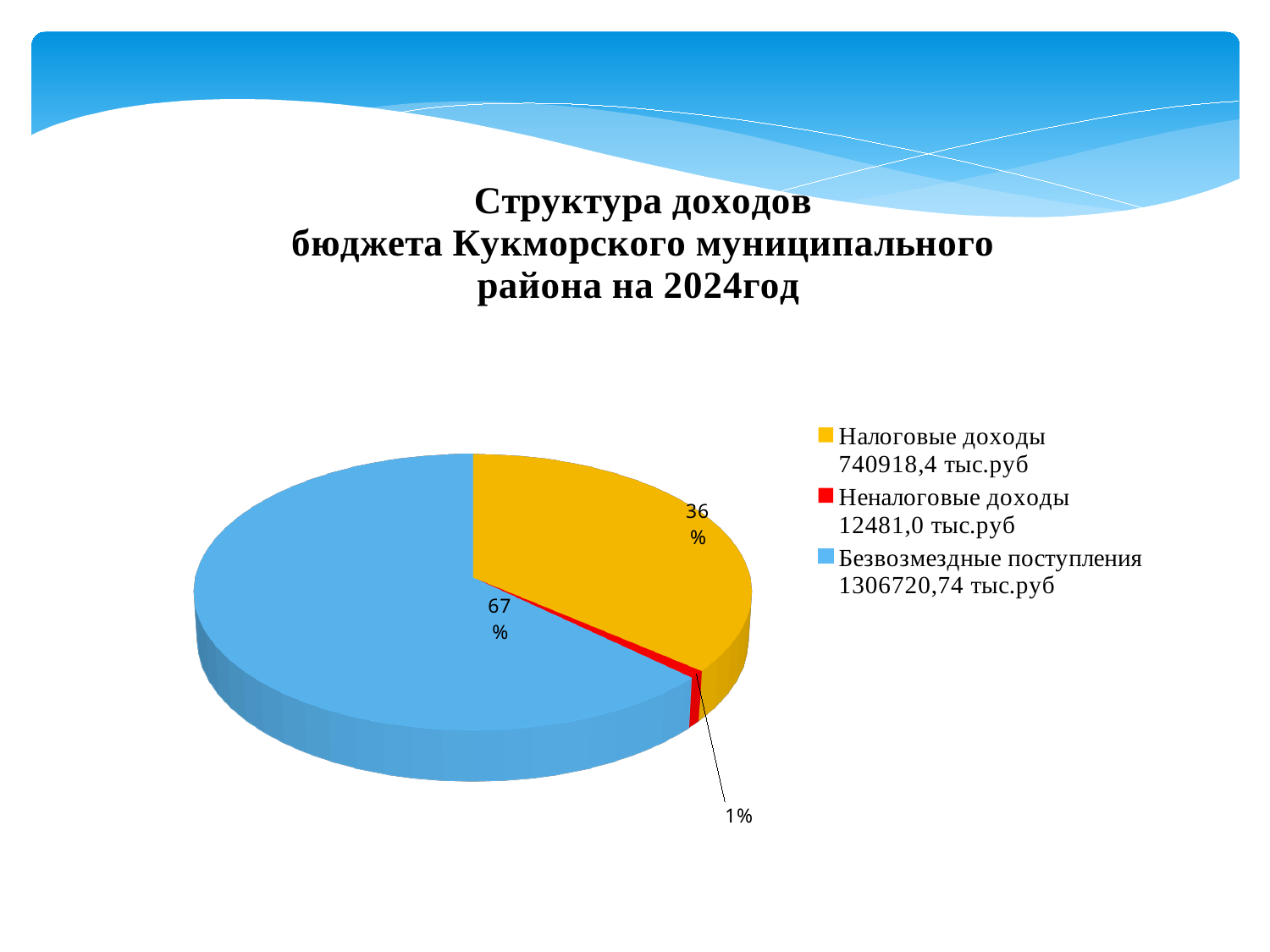
What share of the pie is Безвозмездные поступления? 67% What amount in тыс.руб does the legend give for Налоговые доходы? 740918,4 тыс.руб Which category has the smallest share of the pie? Неналоговые доходы How many entries does the legend list? 3 Which is larger: the share for Налоговые доходы or the share for Безвозмездные поступления? Безвозмездные поступления How many slices does the pie chart have? 3 What is the difference in percentage points between the shares of Безвозмездные поступления and Налоговые доходы? 31 What share of the pie is Налоговые доходы? 36% What kind of chart is shown on the slide? pie chart Which category has the largest share of the pie? Безвозмездные поступления What share of the pie is Неналоговые доходы? 1% What colour is the slice for Неналоговые доходы? red